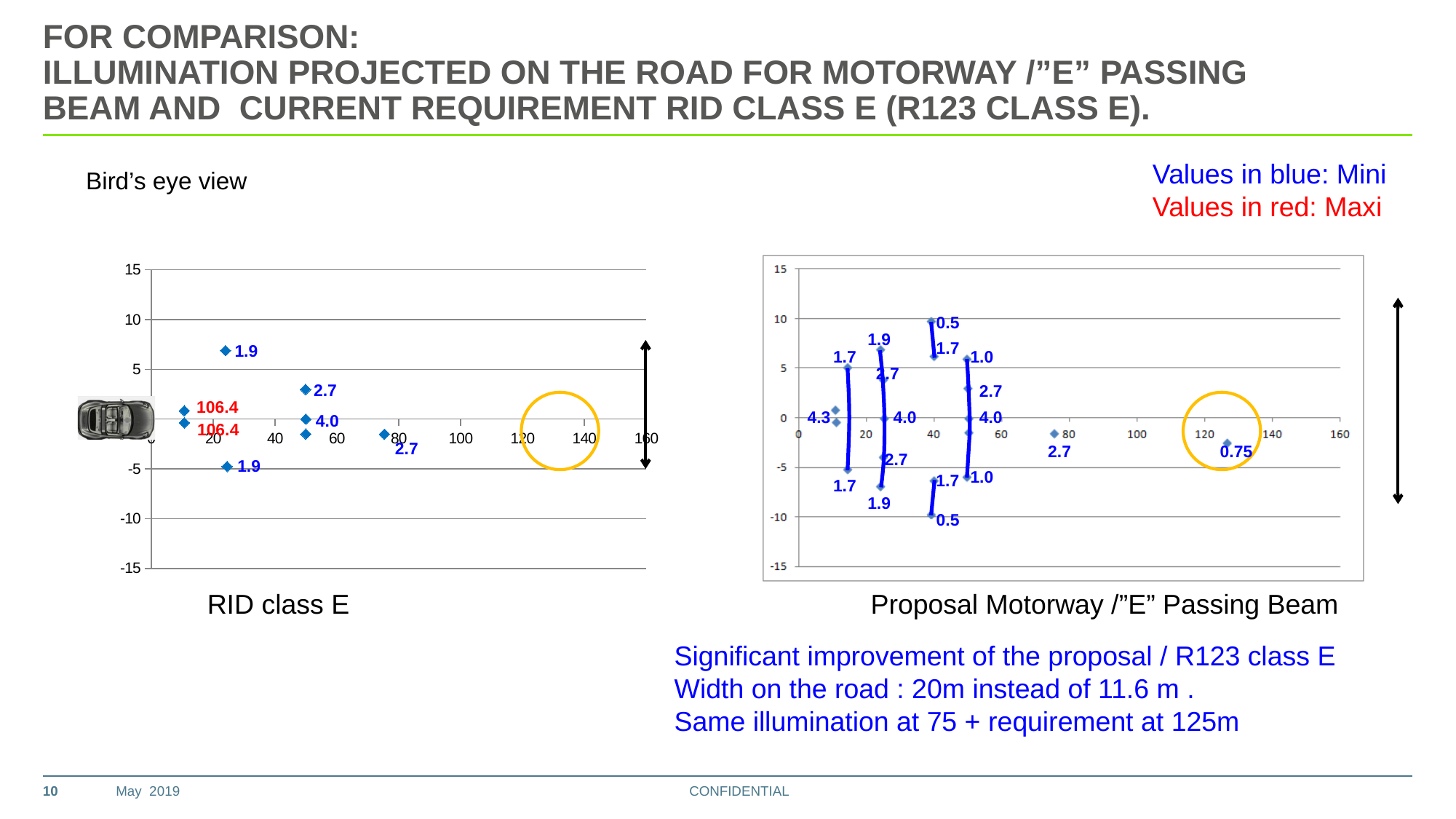
According to the slide, what do the values printed in blue represent? Mini What is the maximum value shown on the horizontal axis of the Proposal Motorway /"E" Passing Beam chart? 160 On the RID class E chart, what value is printed in red next to the car? 106.4 On the RID class E chart, what is the difference between the printed values 4.0 and 2.7? 1.3 On the Proposal Motorway /"E" Passing Beam chart, which printed value is the lowest? 0.5 On the Proposal Motorway /"E" Passing Beam chart, what value is printed at the point inside the yellow circle near x = 125? 0.75 What kind of chart is the RID class E chart on the left? scatter chart On the Proposal Motorway /"E" Passing Beam chart, what value is printed at the point near x = 80? 2.7 On the RID class E chart, which printed value is the highest? 106.4 On the Proposal Motorway /"E" Passing Beam chart, which printed value is the highest? 4.3 On the Proposal Motorway /"E" Passing Beam chart, which is larger: the value printed at x = 0 (4.3) or the value printed near x = 125 (0.75)? 4.3 What is the maximum value shown on the vertical axis of the RID class E chart? 15